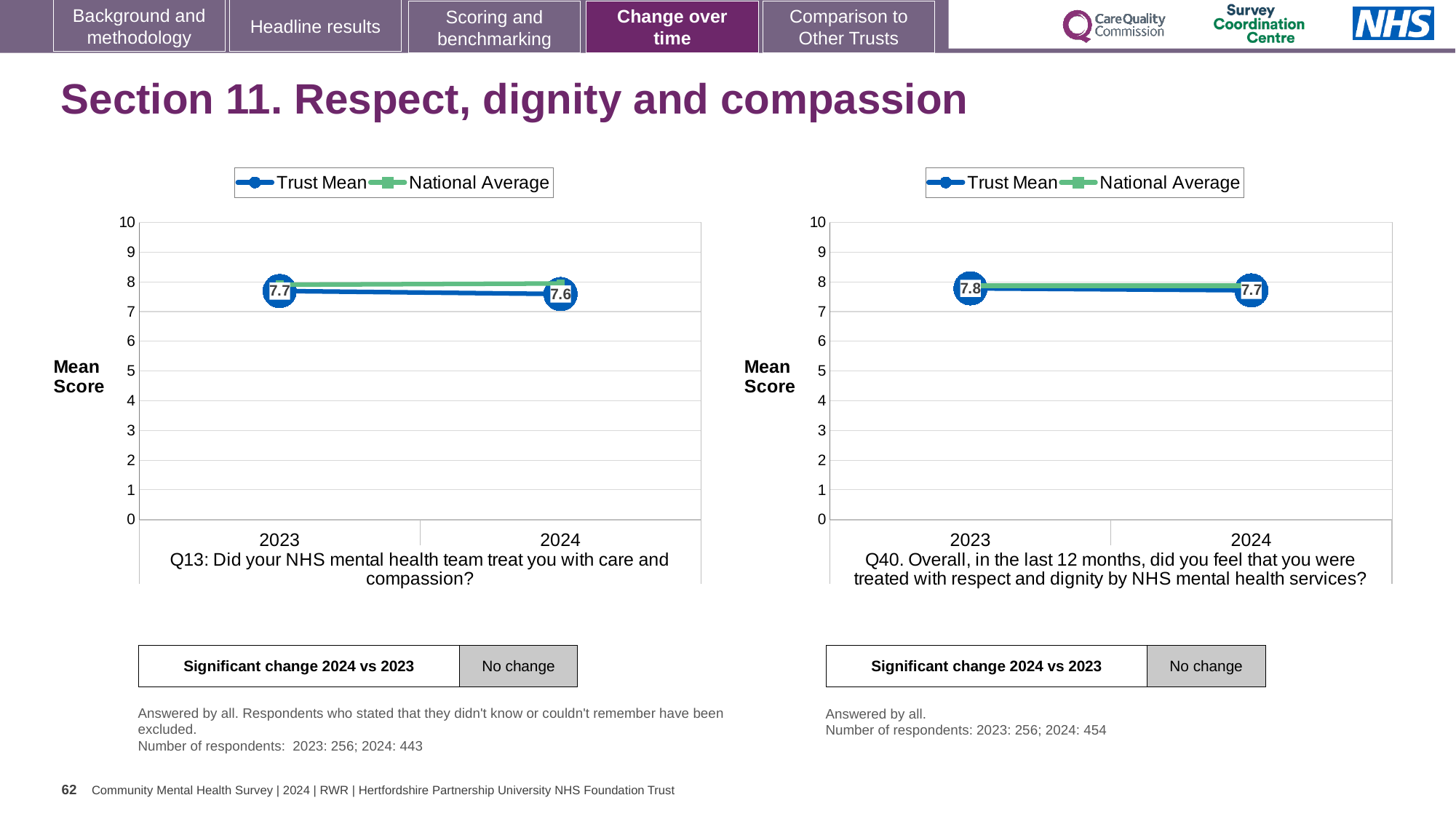
How many years are shown on the x axis of the Q13 chart on the left? 2 In the Q40 chart on the right, what is the Trust Mean for 2024? 7.7 In the Q13 chart on the left, what is the Trust Mean for 2023? 7.7 In the Q13 chart on the left, what is the Trust Mean for 2024? 7.6 How many series does the legend of the Q40 chart on the right list? 2 What kind of chart is the Q13 chart on the left? Line chart In the Q40 chart on the right, is the National Average for 2023 greater or less than 9? less In the Q13 chart on the left, does the Trust Mean rise or fall from 2023 to 2024? Fall In the Q40 chart on the right, what is the difference between the Trust Mean for 2023 and 2024? 0.1 In the Q13 chart on the left, is the National Average for 2024 greater or less than 7? greater In the Q40 chart on the right, what is the Trust Mean for 2023? 7.8 What are the two series named in the legend of the Q13 chart on the left? Trust Mean and National Average